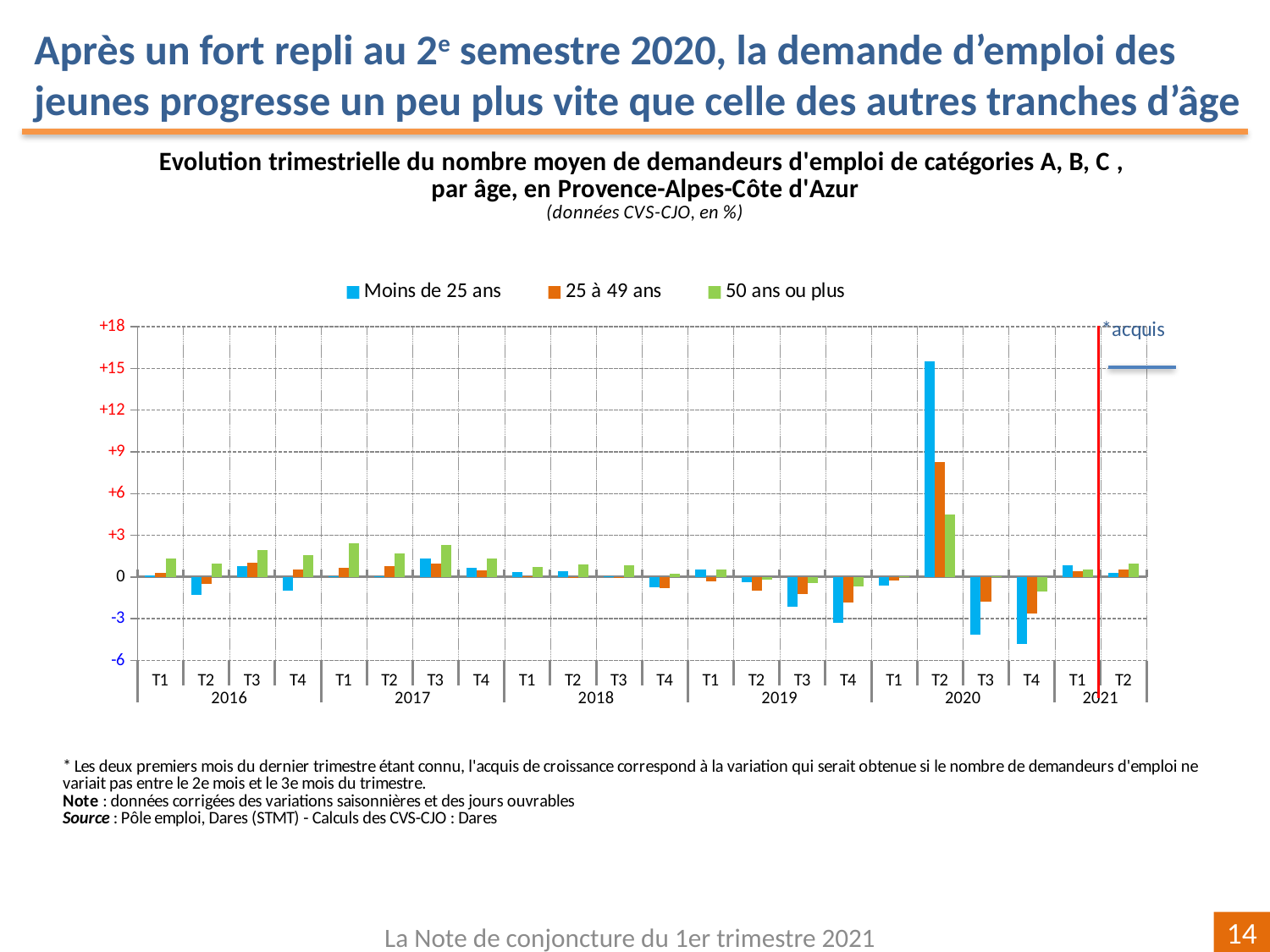
Which series is shown in blue in the legend? Moins de 25 ans In which quarter does the 'Moins de 25 ans' series reach its highest value? T2 2020 Is the value for 'Moins de 25 ans' in T2 2020 greater or less than +12? greater In T1 2017, which is larger: the value for '50 ans ou plus' or for '25 à 49 ans'? 50 ans ou plus Is the value for '50 ans ou plus' in T2 2020 greater or less than +3? greater How many quarters (categories) are plotted along the x axis? 22 What kind of chart is shown on the slide? bar chart Is the value for 'Moins de 25 ans' in T4 2020 greater or less than -3? less What label is written next to the red vertical line at the right of the chart? *acquis How many series does the legend list? 3 In T2 2020, which is larger: the value for 'Moins de 25 ans' or for '25 à 49 ans'? Moins de 25 ans